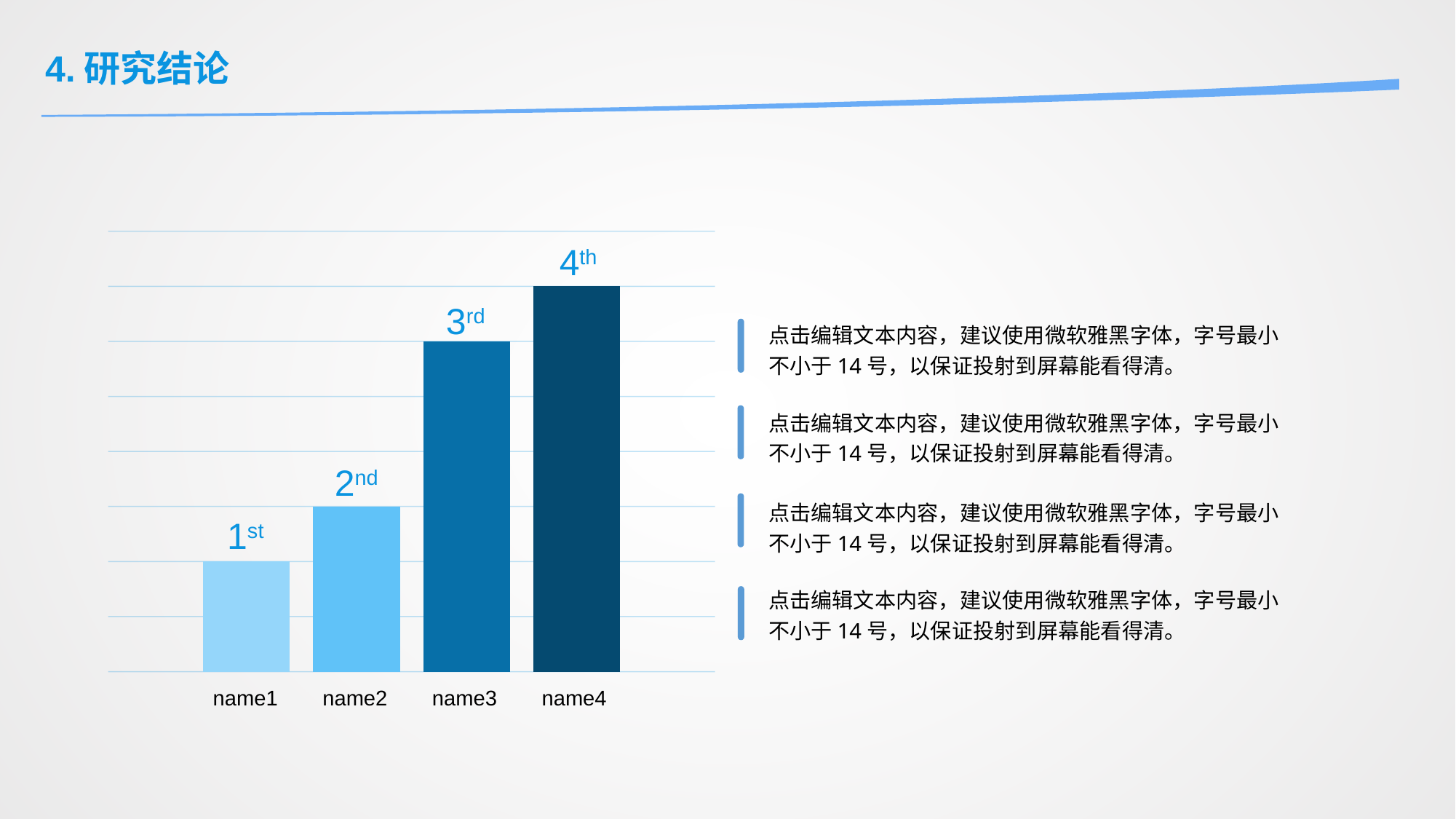
Which category has the tallest bar? name4 Do the bar heights rise or fall from name1 to name4? rise Which category has the shortest bar? name1 What is the category label of the rightmost bar? name4 Which bar is taller, name1 or name4? name4 Which category is labelled "2nd" above its bar? name2 What label is printed above the bar for name3? 3rd What label is printed above the bar for name1? 1st Which bar is drawn in the darkest shade of blue? name4 What kind of chart is shown on the slide? bar chart How many bars are plotted in the chart? 4 Which bar is taller, name2 or name3? name3